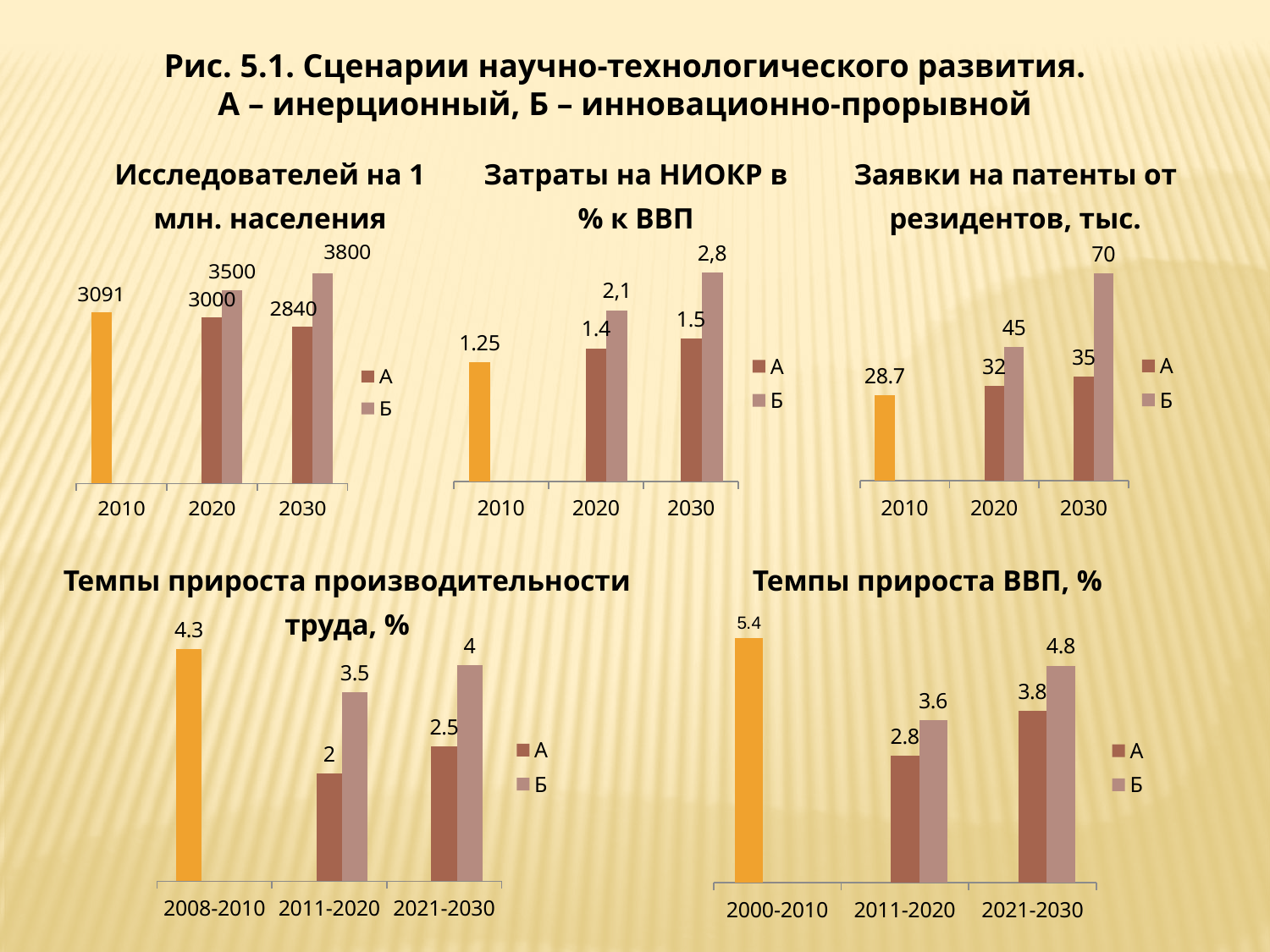
In the chart 'Затраты на НИОКР в % к ВВП', what is the difference between scenario Б and scenario А in 2030? 1,3 In the chart 'Исследователей на 1 млн. населения', what is the value shown for 2010? 3091 How many series does the legend list in the chart 'Темпы прироста ВВП, %'? 2 In the chart 'Затраты на НИОКР в % к ВВП', what is the value for scenario Б in 2020? 2,1 In the chart 'Темпы прироста ВВП, %', which period has the lowest value for scenario А? 2011-2020 In the chart 'Темпы прироста ВВП, %', what is the difference between scenario Б and scenario А in 2021-2030? 1.0 In the chart 'Заявки на патенты от резидентов, тыс.', which bar has the highest value? Б in 2030 In the chart 'Исследователей на 1 млн. населения', what is the value for scenario Б in 2030? 3800 In the chart 'Темпы прироста производительности труда, %', which is larger: scenario А in 2021-2030 or scenario Б in 2011-2020? Б in 2011-2020 In the chart 'Темпы прироста производительности труда, %', what is the value for 2008-2010? 4.3 What type of chart is 'Заявки на патенты от резидентов, тыс.'? Bar chart In the chart 'Заявки на патенты от резидентов, тыс.', what is the value for scenario А in 2020? 32